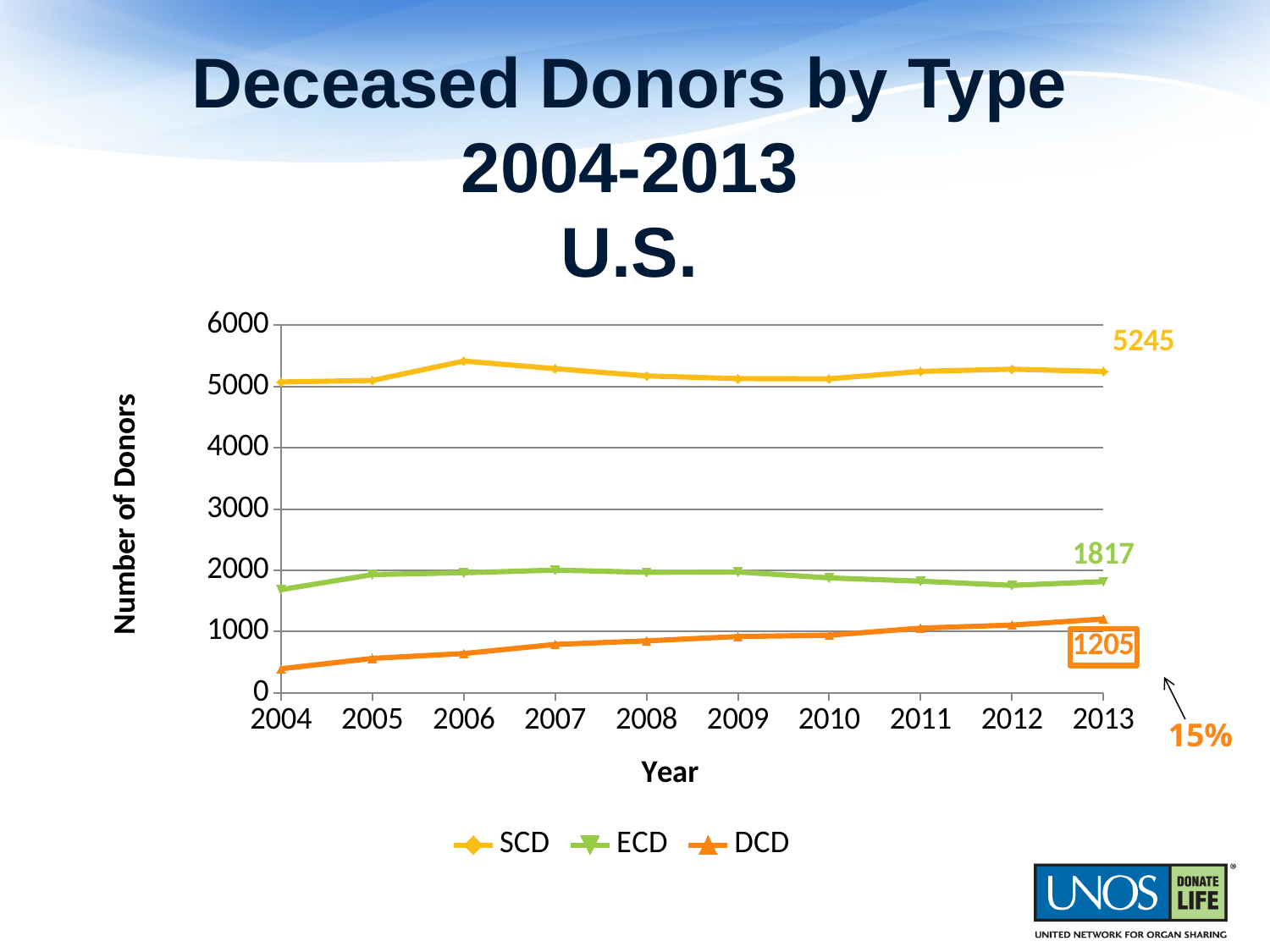
What is the difference between the ECD and DCD values in 2013? 612 What is the value for DCD in 2013? 1205 What kind of chart is shown on the slide? Line chart How many series does the legend list? 3 What is the value for SCD in 2013? 5245 Which series has the lowest value in 2013? DCD What is the difference between the SCD and ECD values in 2013? 3428 Is the value for DCD in 2004 greater or less than 1000? less What is the value for ECD in 2013? 1817 How many years are shown on the x axis? 10 Which series has the highest value in 2013? SCD Is the value for SCD in 2006 greater or less than 5000? greater